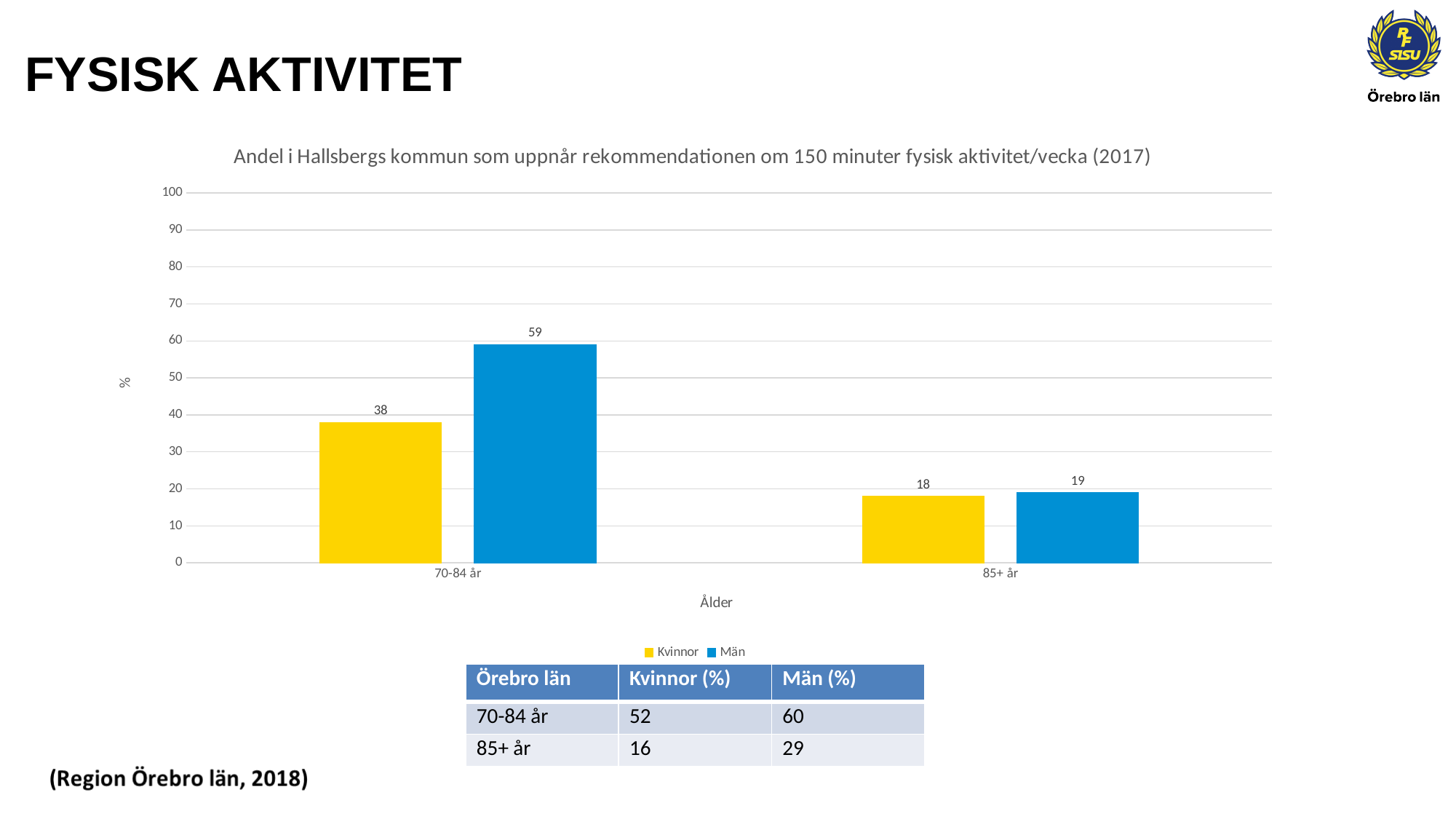
What is the value for Män in the 70-84 år category? 59 What is the difference between the Män and Kvinnor values in the 70-84 år category? 21 What is the label of the x axis? Ålder How many series does the legend list? 2 How many age categories are shown on the x axis? 2 What is the value for Kvinnor in the 70-84 år category? 38 Which is larger in the 70-84 år category, Kvinnor or Män? Män What is the value for Kvinnor in the 85+ år category? 18 What kind of chart is shown on the slide? Bar chart Which bar has the highest value in the chart? Män, 70-84 år What is the value for Män in the 85+ år category? 19 Which bar has the lowest value in the chart? Kvinnor, 85+ år